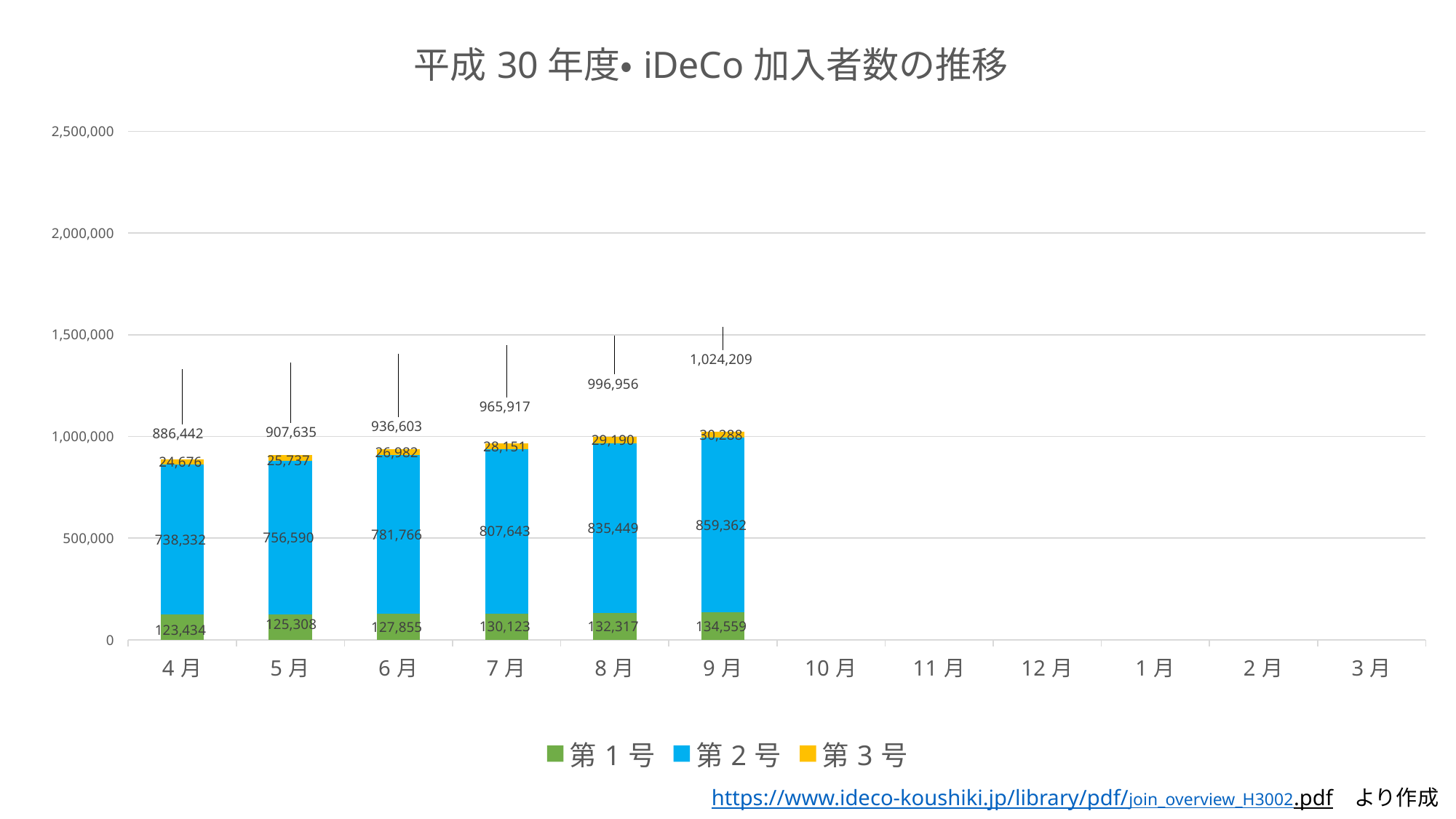
What is the value for 第3号 in 9月? 30,288 How many series does the legend list? 3 What is the value for 第1号 in 4月? 123,434 What is the total of the stacked bar for 8月? 996,956 Do the total values rise or fall from 4月 to 9月? Rise What is the value for 第2号 in 7月? 807,643 What is the difference between the 第2号 values for 9月 and 4月? 121,030 Which is larger, the 第1号 value in 6月 or the 第3号 value in 6月? 第1号 in 6月 How many month categories are shown on the x axis? 12 Among the months with data, which month has the lowest total? 4月 What kind of chart is shown on the slide? Stacked bar chart Which month has the highest total number of iDeCo subscribers? 9月